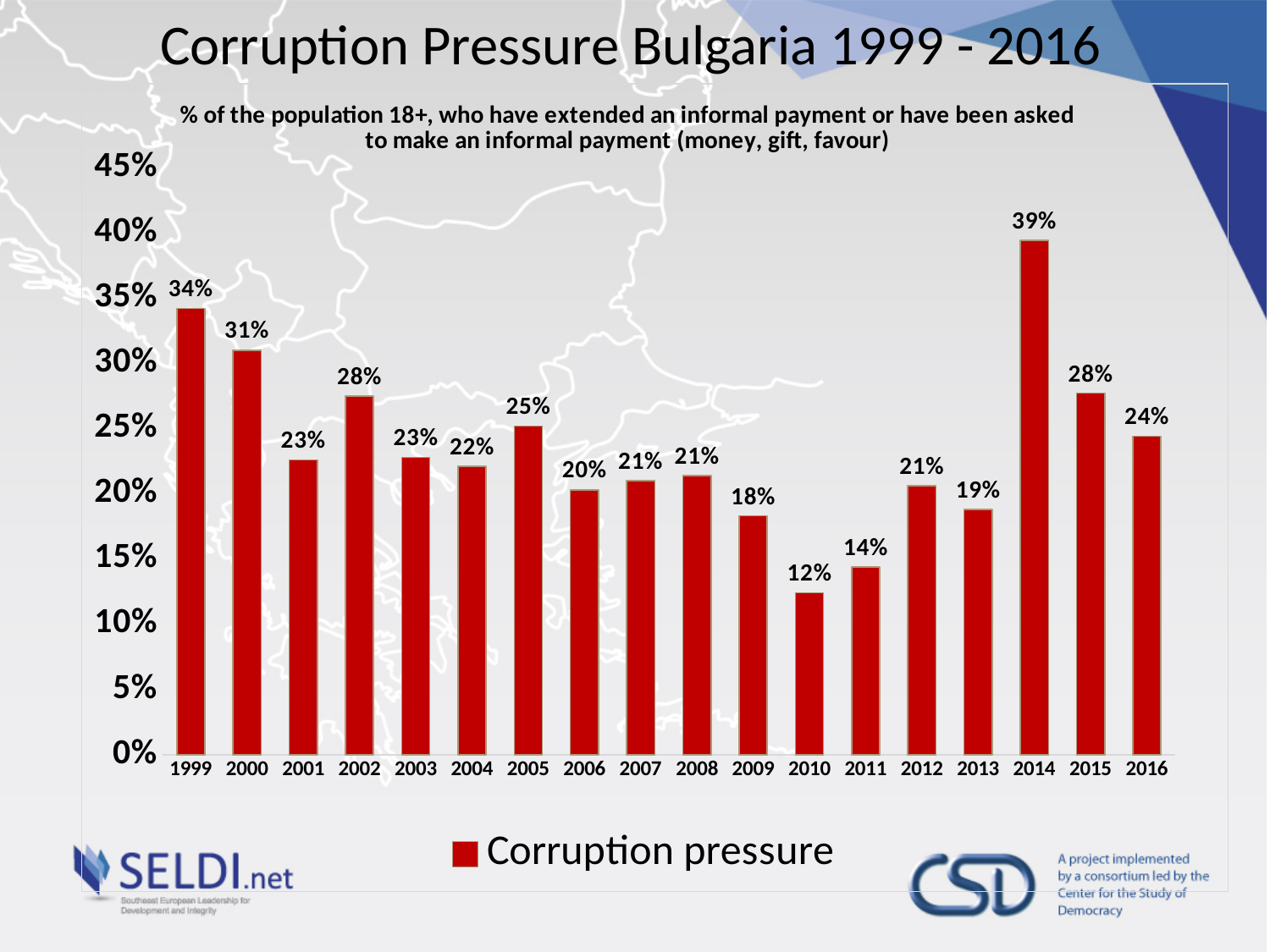
How many series does the legend list? 1 What is the legend entry for the series shown in the chart? Corruption pressure What is the difference between the corruption pressure in 2014 and 2015? 11% Which year has the lowest corruption pressure? 2010 How many years are shown on the x axis of the chart? 18 Which year has a higher corruption pressure, 2000 or 2016? 2000 What is the corruption pressure value for 2014? 39% Which year has the highest corruption pressure? 2014 What kind of chart is shown on the slide? Bar chart What is the corruption pressure value for 2010? 12% What is the corruption pressure value for 1999? 34% Is the corruption pressure value for 2009 greater or less than 20%? less